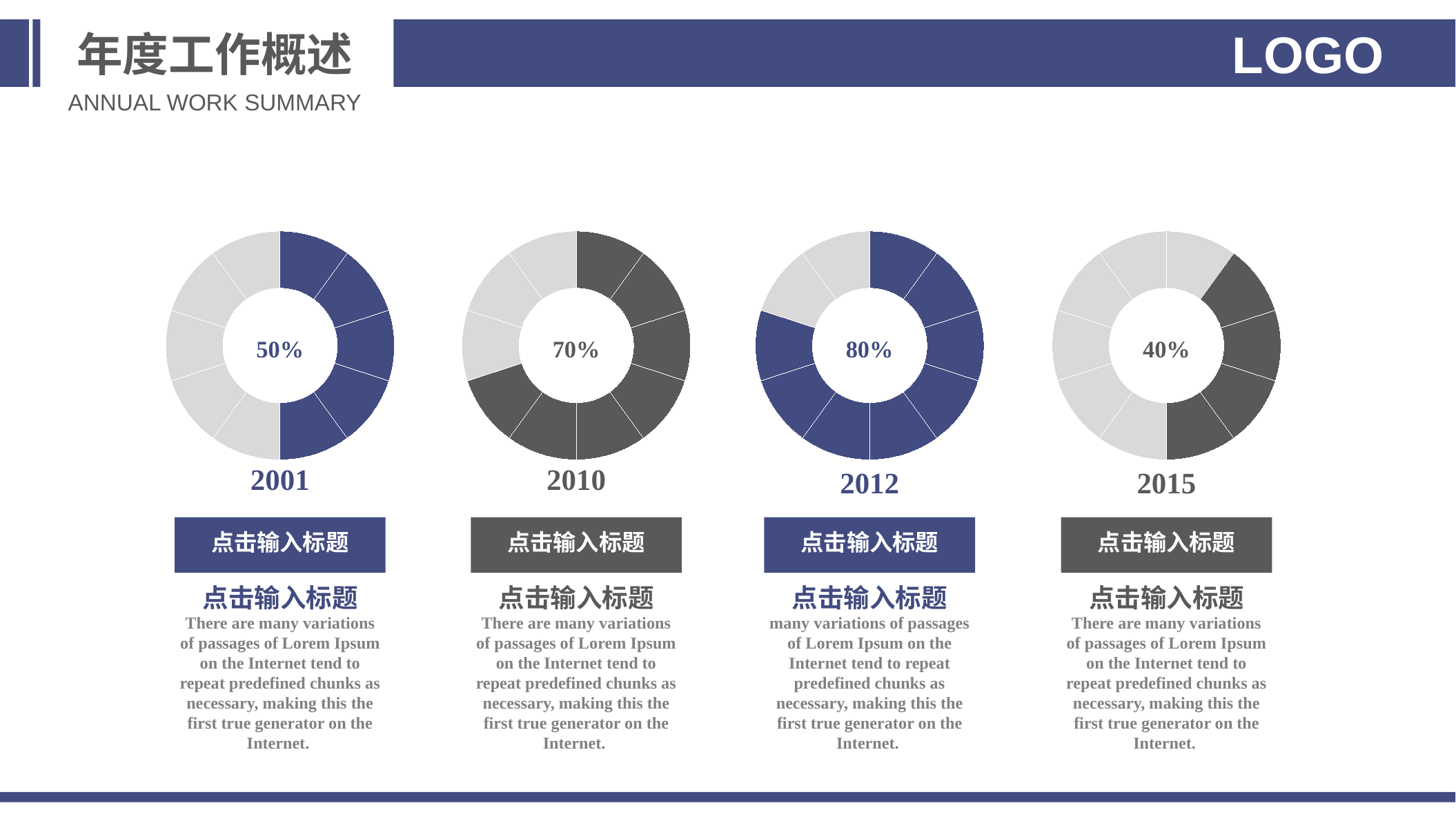
Which year's donut chart shows the lowest percentage? 2015 What is the difference between the percentage shown for 2010 and the percentage shown for 2015? 30% How many donut charts are on the slide? 4 Which shows a larger percentage, the 2010 chart or the 2015 chart? 2010 What percentage is shown in the centre of the 2001 donut chart? 50% What kind of chart is used to show the percentage for each year? Donut chart What is the difference between the percentage shown for 2012 and the percentage shown for 2001? 30% What percentage is shown in the centre of the 2012 donut chart? 80% What percentage is shown in the centre of the 2010 donut chart? 70% Which year's donut chart shows the highest percentage? 2012 What colour is the filled portion of the 2012 donut chart? Blue What percentage is shown in the centre of the 2015 donut chart? 40%